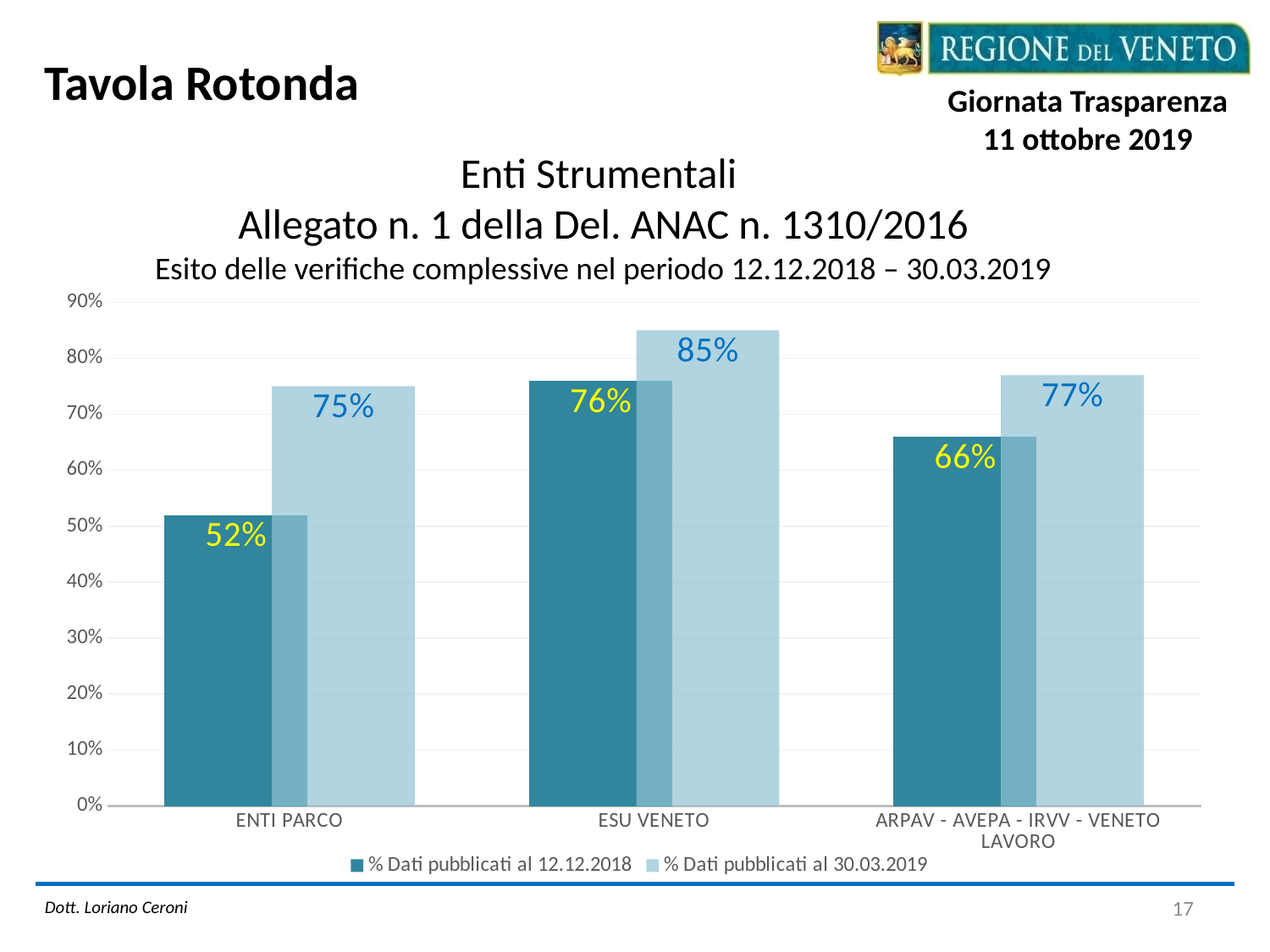
What is the value of '% Dati pubblicati al 12.12.2018' for ENTI PARCO? 52% Which category has the highest value for '% Dati pubblicati al 30.03.2019'? ESU VENETO What is the difference between the 30.03.2019 and 12.12.2018 values for ARPAV - AVEPA - IRVV - VENETO LAVORO? 11% What is the difference between the 30.03.2019 and 12.12.2018 values for ENTI PARCO? 23% What kind of chart is shown on the slide? Bar chart What is the value of '% Dati pubblicati al 30.03.2019' for ESU VENETO? 85% What is the value of '% Dati pubblicati al 30.03.2019' for ENTI PARCO? 75% Which category has the lowest value for '% Dati pubblicati al 12.12.2018'? ENTI PARCO What is the value of '% Dati pubblicati al 12.12.2018' for ARPAV - AVEPA - IRVV - VENETO LAVORO? 66% How many categories are shown on the x axis? 3 How many series does the legend list? 2 Which is larger: the 12.12.2018 value for ESU VENETO or the 30.03.2019 value for ENTI PARCO? 12.12.2018 value for ESU VENETO